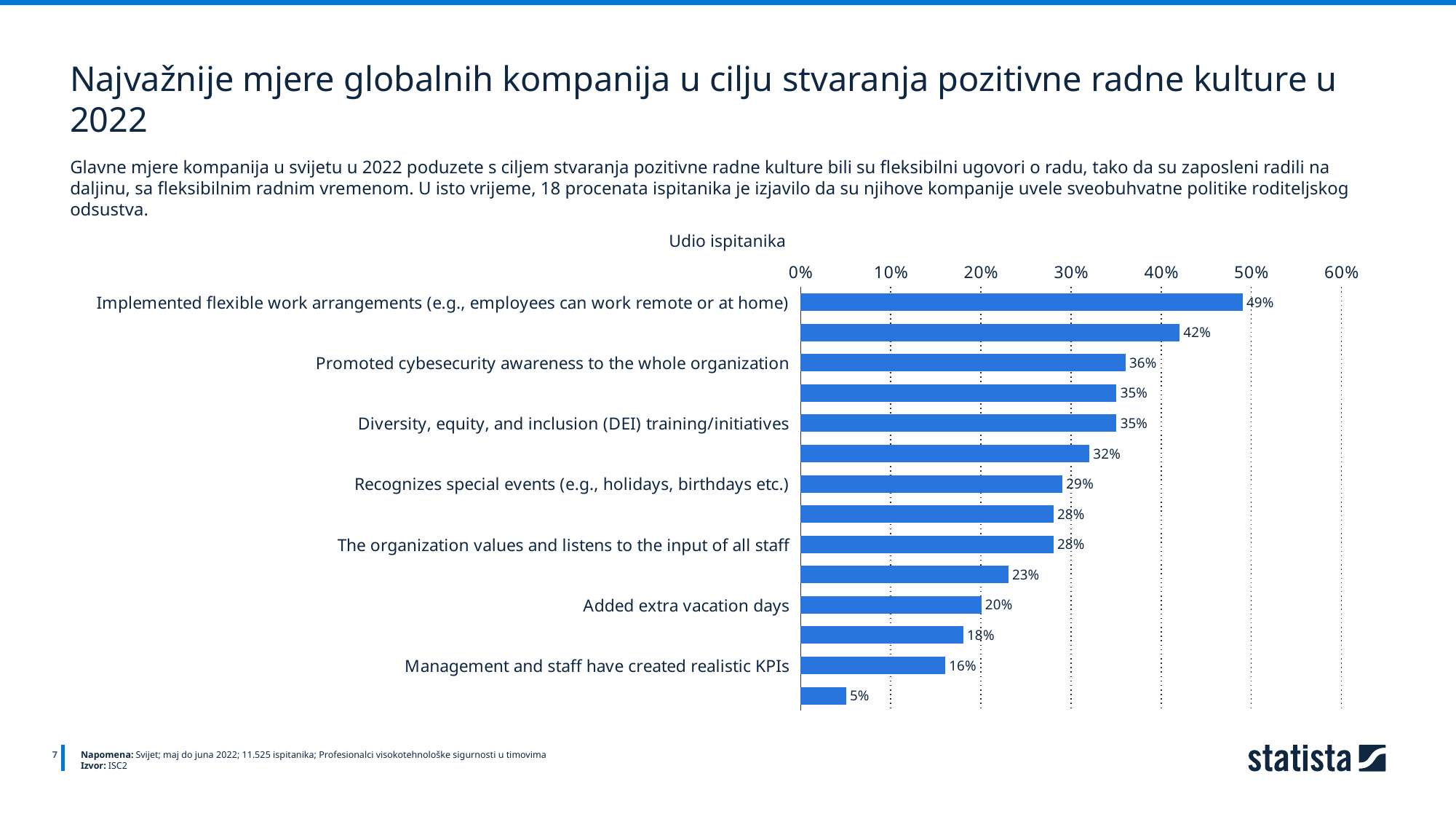
Is the value for "The organization values and listens to the input of all staff" greater or less than 30%? less What type of chart is shown on the slide? bar chart What is the value for "Added extra vacation days"? 20% Which category has the highest value? Implemented flexible work arrangements (e.g., employees can work remote or at home) What is the value for "Promoted cybesecurity awareness to the whole organization"? 36% What is the lowest value shown on the chart? 5% What is the value for "Implemented flexible work arrangements (e.g., employees can work remote or at home)"? 49% What is the difference between the values for "Implemented flexible work arrangements" and "Promoted cybesecurity awareness to the whole organization"? 13% What is the axis title shown above the chart? Udio ispitanika How many bars are plotted on the chart? 14 What is the value for "Management and staff have created realistic KPIs"? 16% Which is larger: the value for "Diversity, equity, and inclusion (DEI) training/initiatives" or for "Recognizes special events (e.g., holidays, birthdays etc.)"? Diversity, equity, and inclusion (DEI) training/initiatives